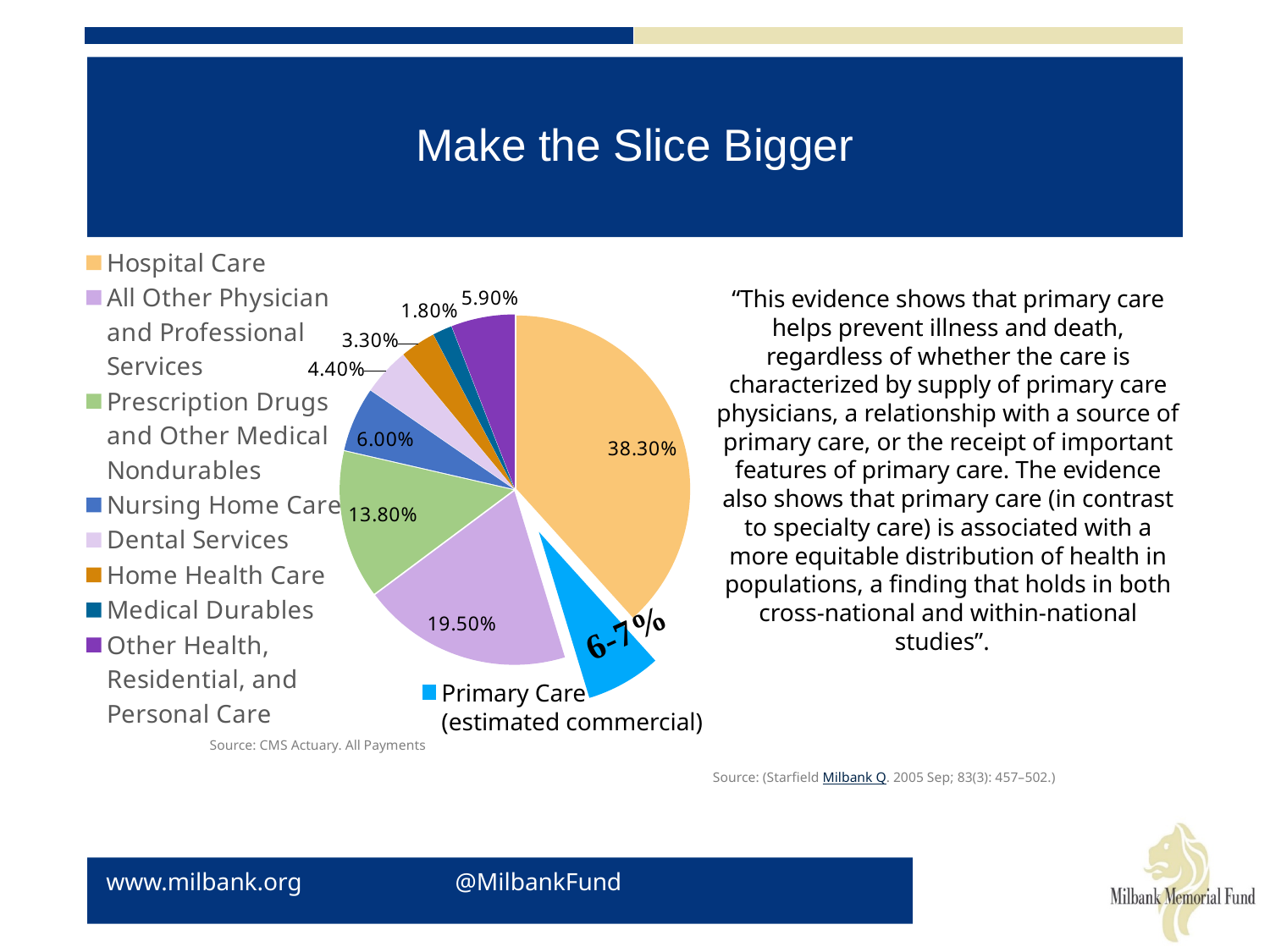
What percentage of the pie is Hospital Care? 38.30% What is the title of the slide containing the chart? Make the Slice Bigger What percentage is shown for Nursing Home Care? 6.00% What type of chart is shown on the slide? Pie chart Which category has the largest slice of the pie? Hospital Care Which is larger, Dental Services or Home Health Care? Dental Services Which category has the smallest slice of the pie? Medical Durables What percentage is shown for All Other Physician and Professional Services? 19.50% What value is labelled on the Primary Care (estimated commercial) slice? 6-7% How many slices does the pie chart have? 9 What is the difference in percentage points between Hospital Care and All Other Physician and Professional Services? 18.80% What percentage is shown for Prescription Drugs and Other Medical Nondurables? 13.80%